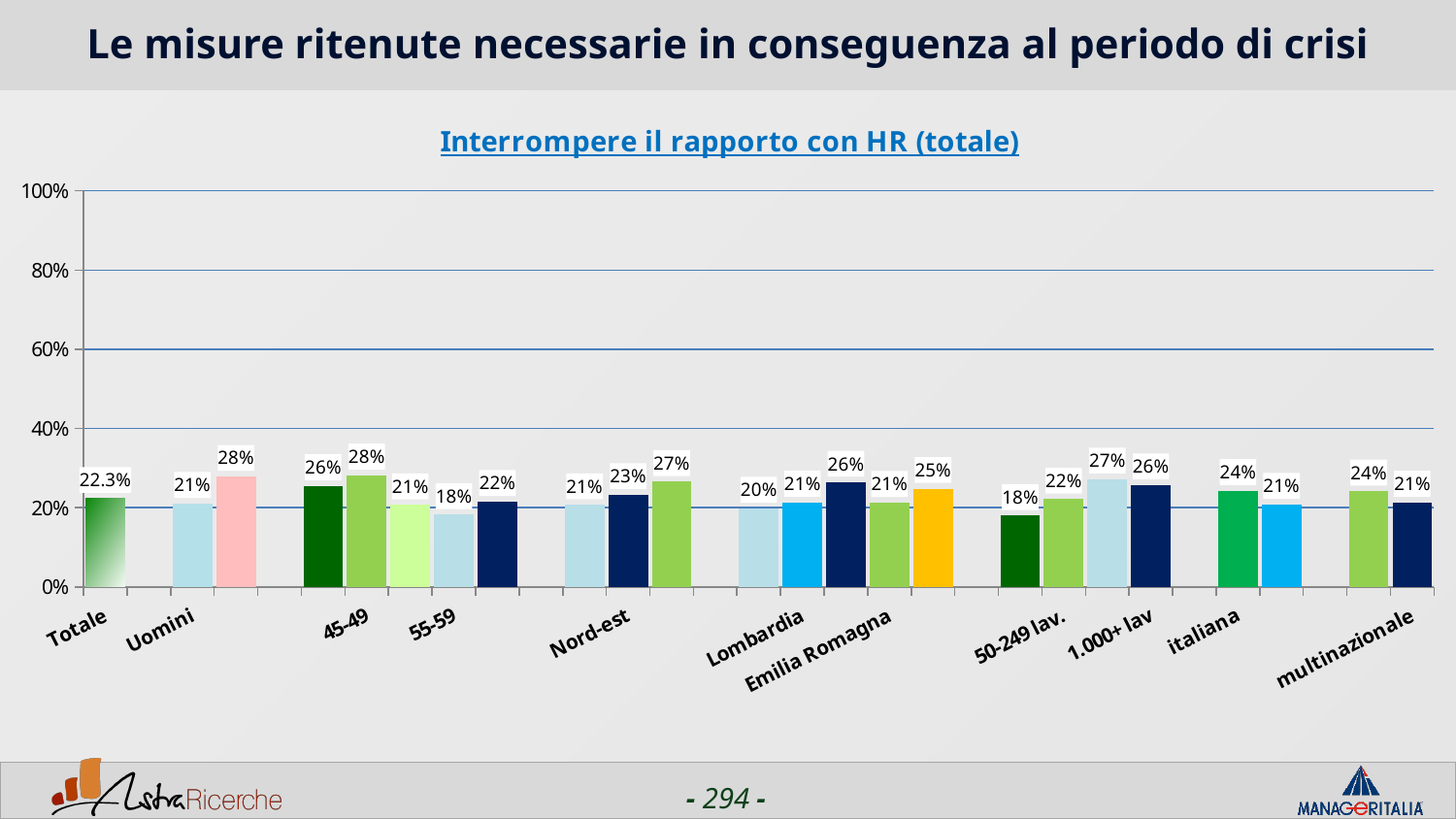
What is the value for italiana? 24% What is the difference between the values for 45-49 and 55-59? 10% What is the value for Nord-est? 23% Is the value for multinazionale greater or less than 40%? less What is the value for Totale? 22.3% What is the value for Uomini? 21% What is the value for 1.000+ lav? 26% What type of chart is shown on the slide? bar chart Which is larger, the value for 1.000+ lav or the value for 50-249 lav.? 1.000+ lav What is the value for the 45-49 age group? 28% What is the title of the chart? Interrompere il rapporto con HR (totale) What is the value for the 55-59 age group? 18%